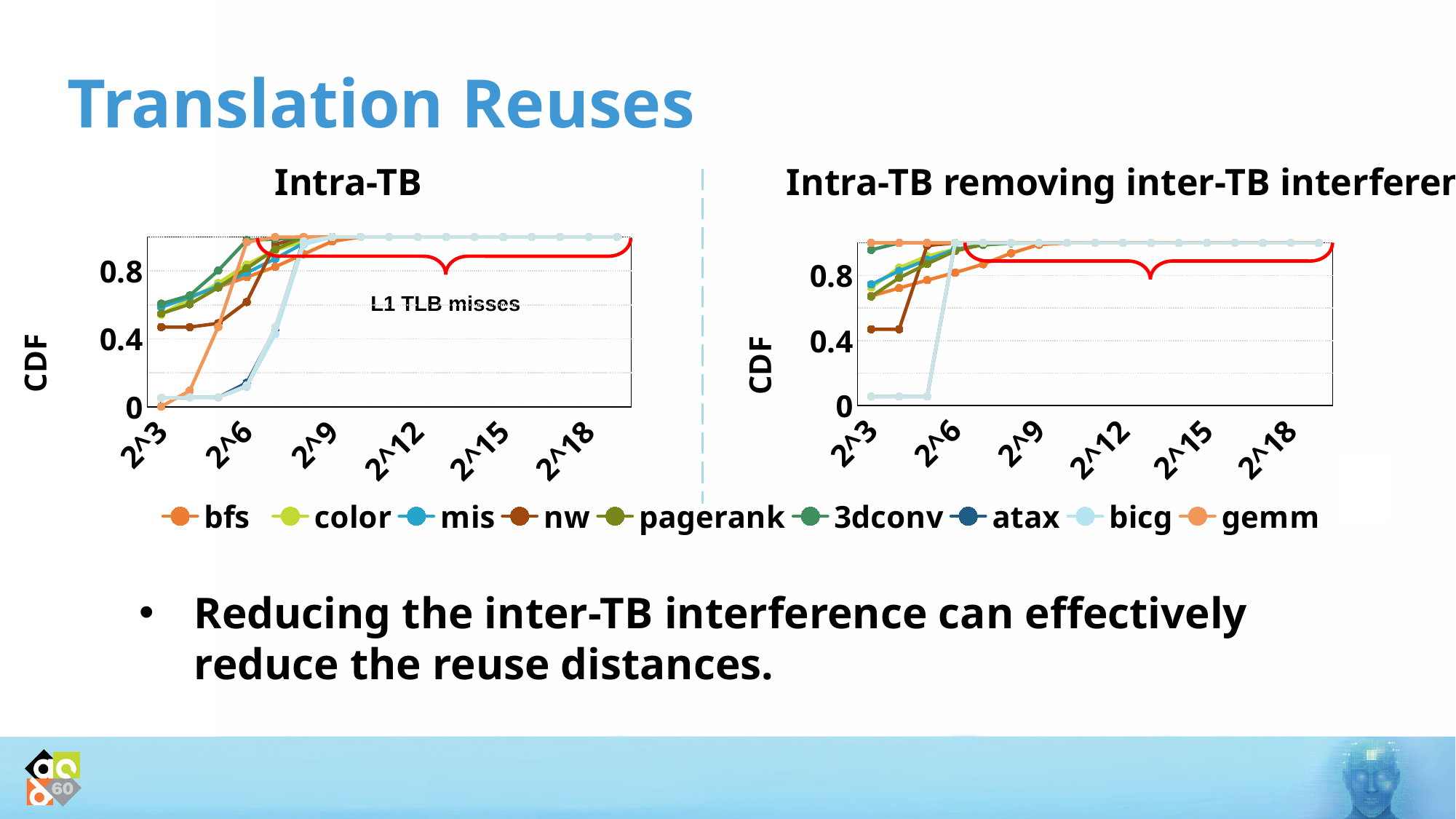
In the Intra-TB chart, is the value for 3dconv at 2^6 greater or less than 0.8? greater In the right-hand chart (Intra-TB removing inter-TB interference), is the value for bicg at 2^3 greater or less than 0.4? less In the Intra-TB chart, is the value for bfs at 2^3 greater or less than 0.4? greater How many series does the shared legend list? 9 In the Intra-TB chart, do the CDF values rise or fall along the x axis? rise What is the y-axis label of the Intra-TB chart? CDF What text annotation appears inside the Intra-TB chart near the red brace? L1 TLB misses What kind of chart is the Intra-TB chart? line chart In the Intra-TB chart, which series has the lowest value at 2^3, bfs or nw? nw How many labelled tick marks are on the x axis of the Intra-TB chart? 6